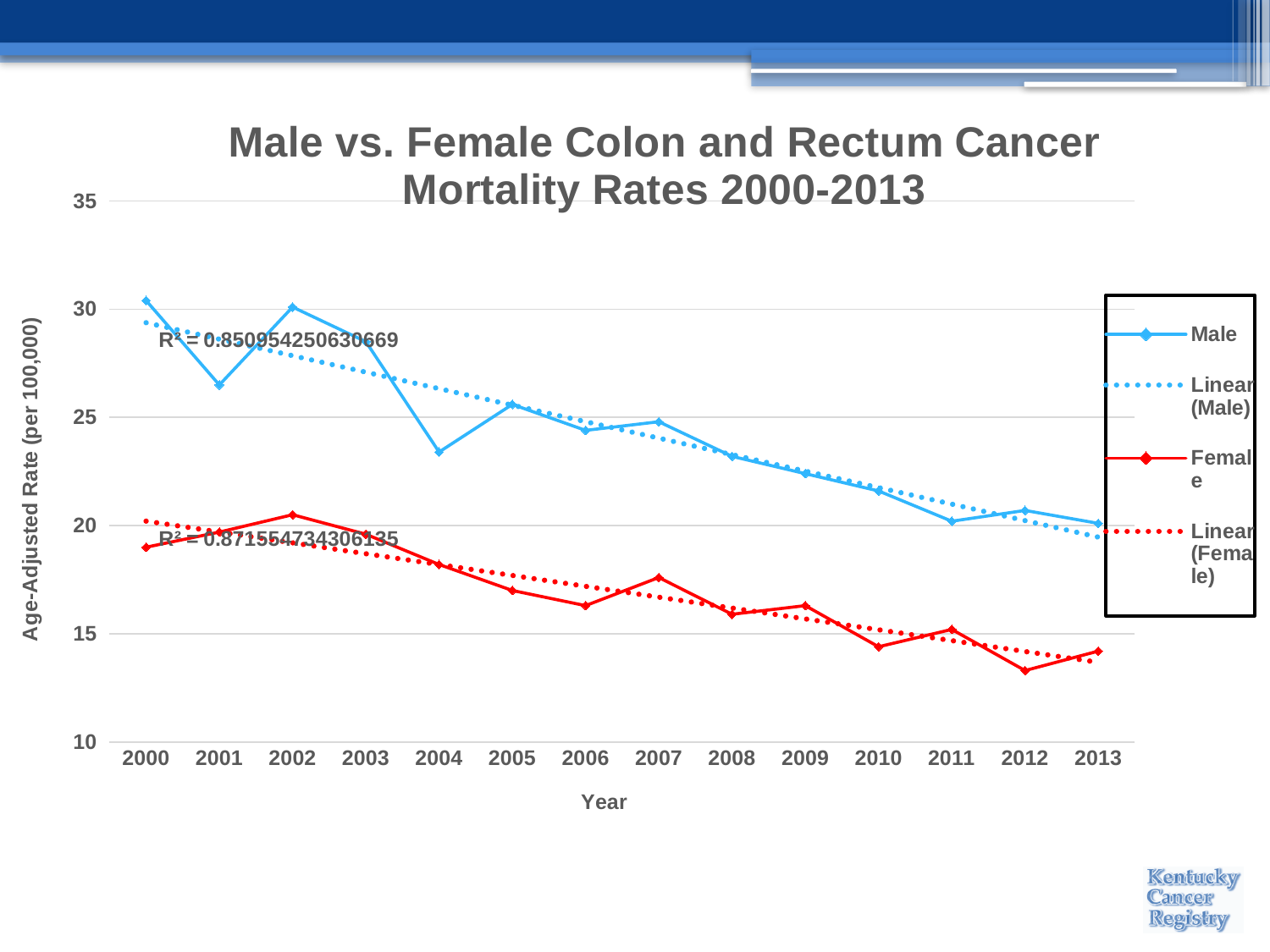
Which series has the higher value in 2000, Male or Female? Male How many entries does the legend list? 4 Is the Male value for 2004 greater or less than 25? less Do the Male mortality rates generally rise or fall from 2000 to 2013? Fall Is the Male value for 2000 greater or less than 30? greater What is the label on the y axis? Age-Adjusted Rate (per 100,000) What is the title of the chart? Male vs. Female Colon and Rectum Cancer Mortality Rates 2000-2013 Is the Female value for 2012 greater or less than 15? less In which year is the Female series at its lowest? 2012 Do the Female mortality rates generally rise or fall from 2000 to 2013? Fall What kind of chart is shown on the slide? Line chart How many years are plotted along the x axis? 14